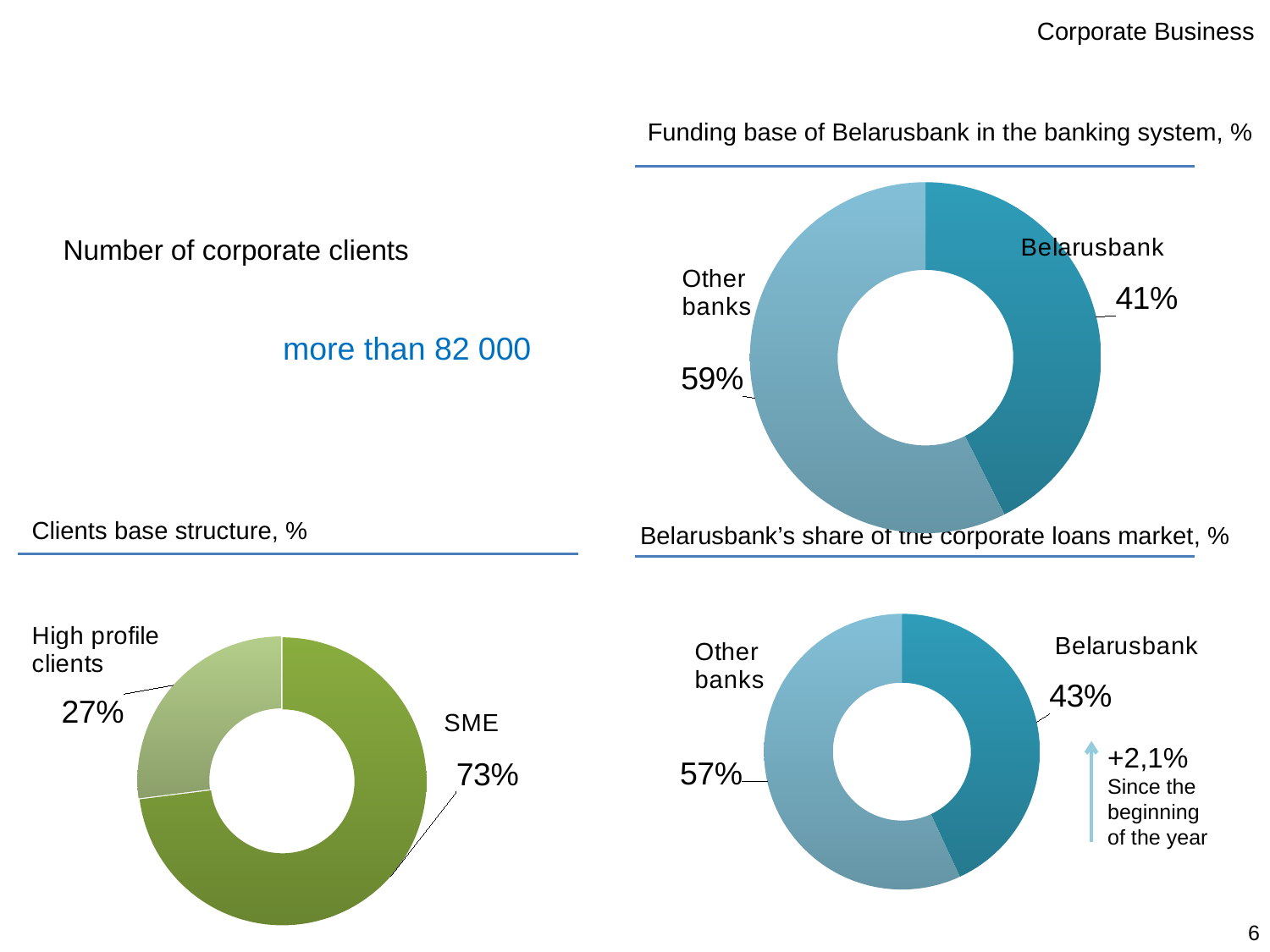
In the 'Clients base structure, %' chart, which slice is the smallest? High profile clients In the 'Belarusbank's share of the corporate loans market, %' chart, which is larger, Belarusbank or Other banks? Other banks In the 'Clients base structure, %' chart, how many slices are there? 2 In the 'Funding base of Belarusbank in the banking system, %' chart, what is the difference between Other banks and Belarusbank? 18% In the 'Clients base structure, %' chart, what is the value for SME? 73% In the 'Belarusbank's share of the corporate loans market, %' chart, what is the value for Belarusbank? 43% In the 'Funding base of Belarusbank in the banking system, %' chart, which slice is the largest? Other banks In the 'Clients base structure, %' chart, what is the value for High profile clients? 27% What kind of chart is the 'Clients base structure, %' chart? Doughnut (pie) chart In the 'Funding base of Belarusbank in the banking system, %' chart, what is the value for Other banks? 59% In the 'Belarusbank's share of the corporate loans market, %' chart, what is the value for Other banks? 57% In the 'Funding base of Belarusbank in the banking system, %' chart, what is the value for Belarusbank? 41%